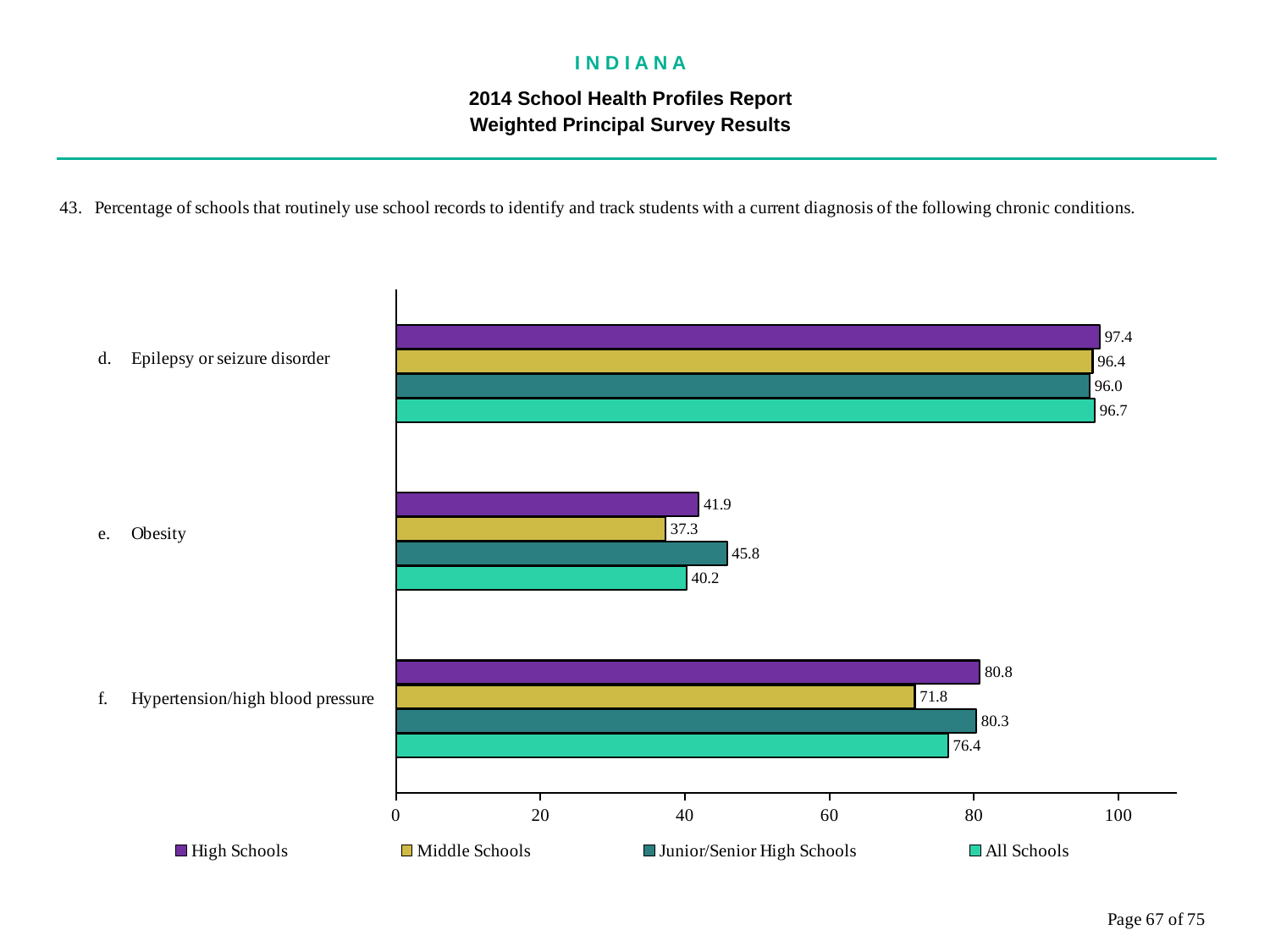
What is the value for High Schools for Epilepsy or seizure disorder? 97.4 Which school type has the highest value for Hypertension/high blood pressure? High Schools Which is larger for Obesity: the High Schools value or the All Schools value? High Schools What is the value for All Schools for Hypertension/high blood pressure? 76.4 Which series is shown in purple in the legend? High Schools How many chronic conditions are shown on the chart? 3 What is the difference between the High Schools and Middle Schools values for Hypertension/high blood pressure? 9.0 Which school type has the lowest value for Obesity? Middle Schools How many series does the legend list? 4 What is the value for Junior/Senior High Schools for Obesity? 45.8 What is the value for Middle Schools for Obesity? 37.3 What kind of chart is shown on the slide? Bar chart